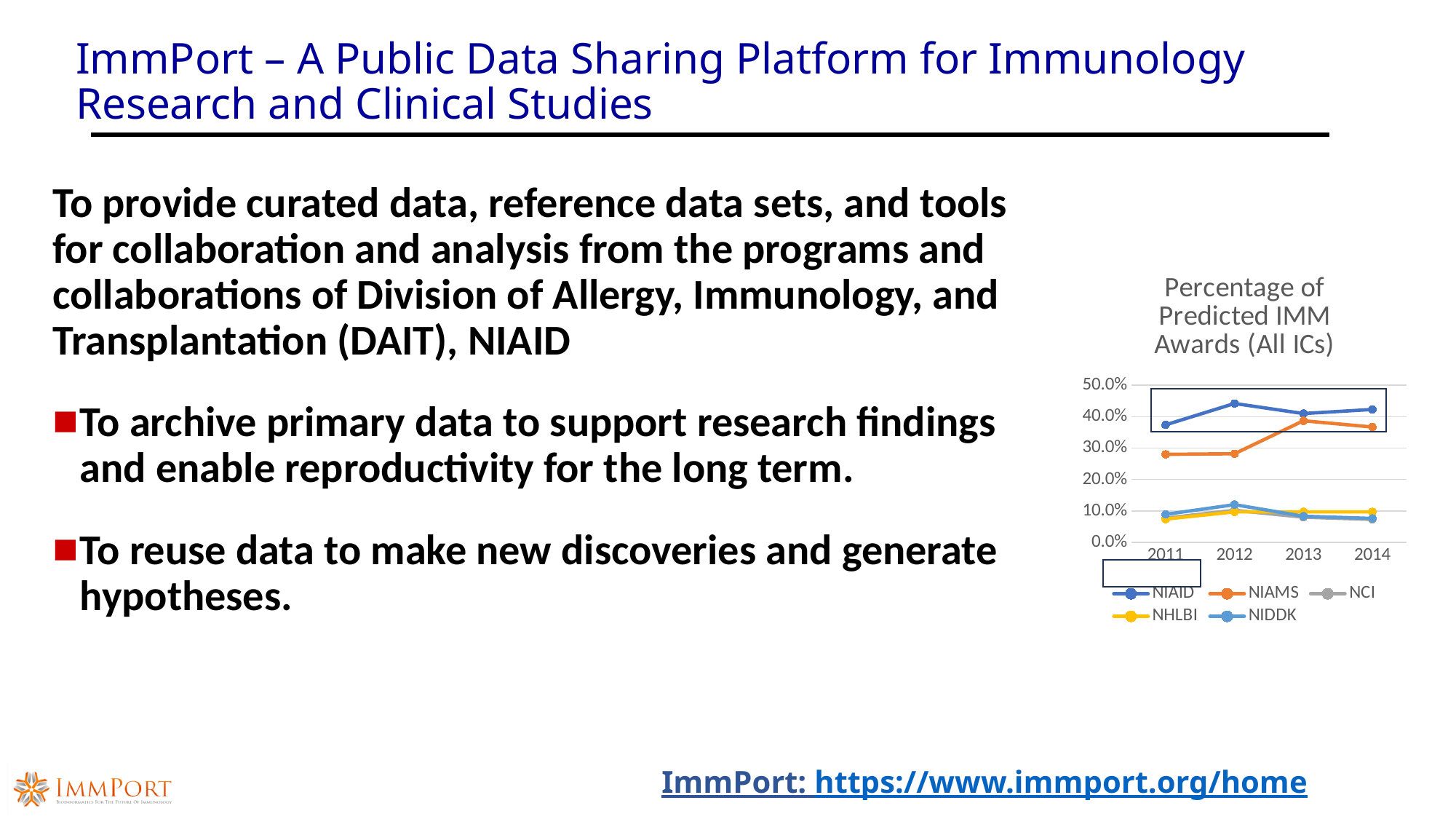
What is the title of the chart? Percentage of Predicted IMM Awards (All ICs) Is the value for NIAMS in 2013 greater or less than 30.0%? greater Does the NIAMS line rise or fall from 2011 to 2013? rise Which is larger in 2012, the value for NIAID or the value for NIAMS? NIAID In which year does the NIAID series reach its highest value? 2012 Is the value for NIDDK in 2012 greater or less than 20.0%? less Which series has the highest value in 2011? NIAID Is the value for NIAID in 2012 greater or less than 40.0%? greater What kind of chart is shown on the slide? line chart How many series does the legend of the chart list? 5 How many years are shown on the x axis of the chart? 4